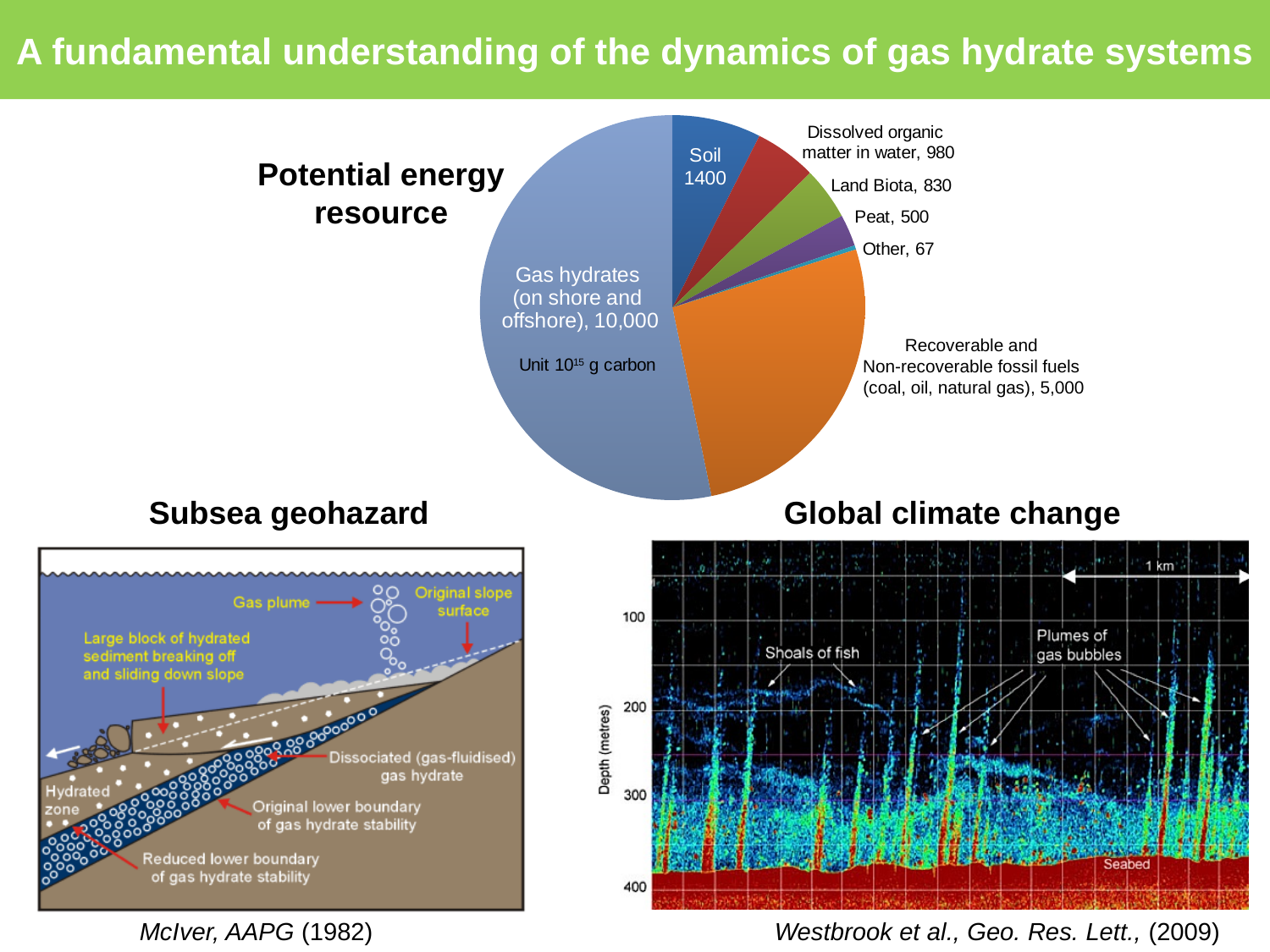
In the pie chart, what is the difference between the value for Gas hydrates and the value for Recoverable and Non-recoverable fossil fuels? 5,000 In the pie chart, what is the value for Peat? 500 What kind of chart is shown under the heading 'Potential energy resource'? pie chart In the pie chart, which is larger: the value for Land Biota or the value for Peat? Land Biota In the pie chart, what is the value for Soil? 1400 In the pie chart, what is the value for Dissolved organic matter in water? 980 Which slice of the pie chart has the largest value? Gas hydrates (on shore and offshore) Which slice of the pie chart has the smallest value? Other In the pie chart, what is the value for Recoverable and Non-recoverable fossil fuels (coal, oil, natural gas)? 5,000 What unit is stated for the values in the pie chart? 10^15 g carbon How many slices does the pie chart have? 7 In the pie chart, what is the value for Gas hydrates (on shore and offshore)? 10,000